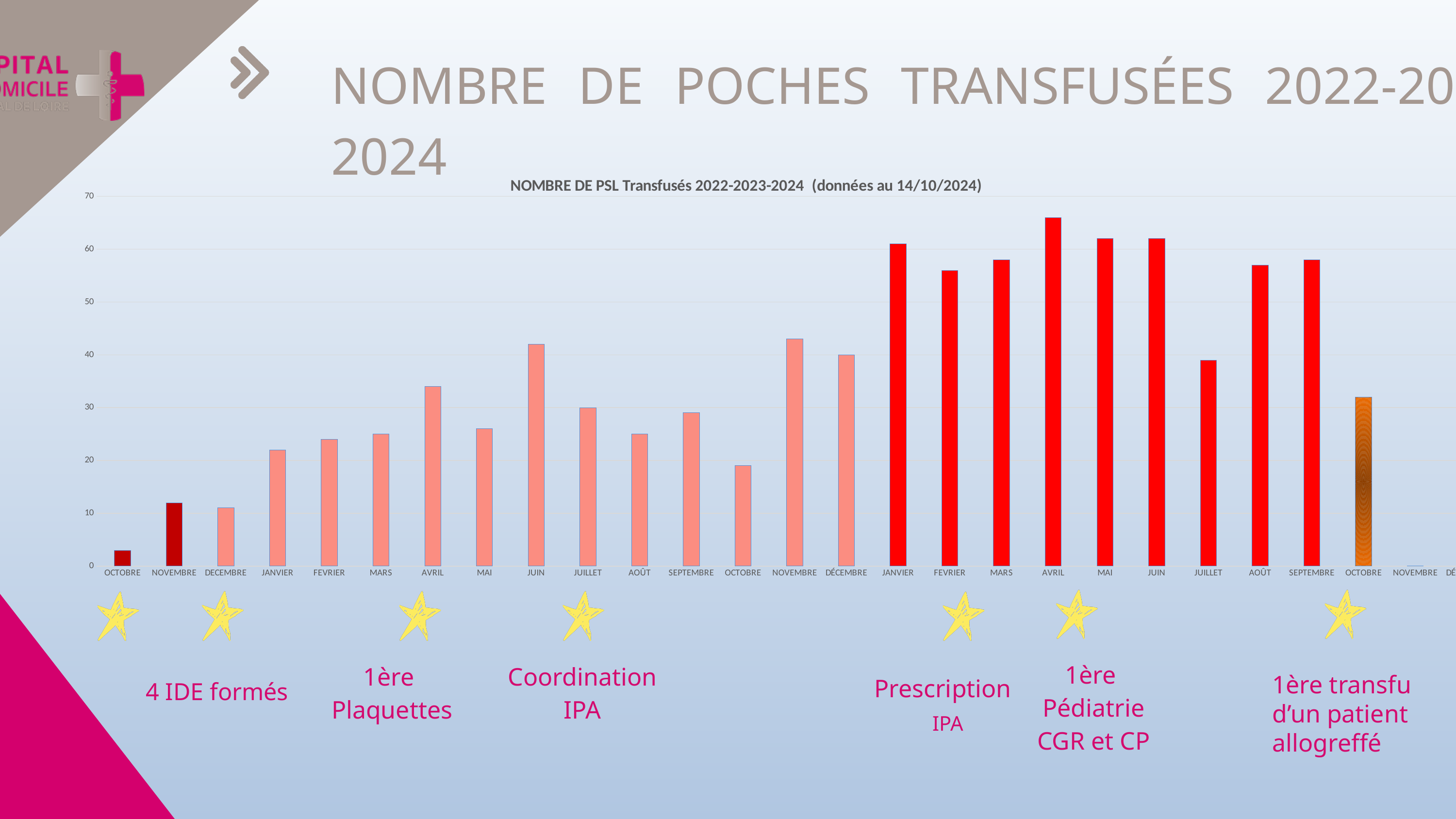
Which month label has the tallest bar in the chart? AVRIL Which is taller: the first AVRIL bar or the first MAI bar? the first AVRIL bar What is the title printed above the chart? NOMBRE DE PSL Transfusés 2022-2023-2024 (données au 14/10/2024) What kind of chart is shown on the slide? bar chart Which bar is the shortest in the chart? the leftmost OCTOBRE bar Is the value for the first JANVIER bar (salmon-coloured) greater or less than 20? greater Overall, do the bars generally rise or fall from left to right across the chart? rise Is the value for the rightmost OCTOBRE bar (orange) greater or less than 40? less What is the highest value shown on the vertical axis? 70 Is the value for the leftmost OCTOBRE bar greater or less than 10? less Which is taller: the JUILLET bar or the AOÛT bar in the bright red group? the AOÛT bar